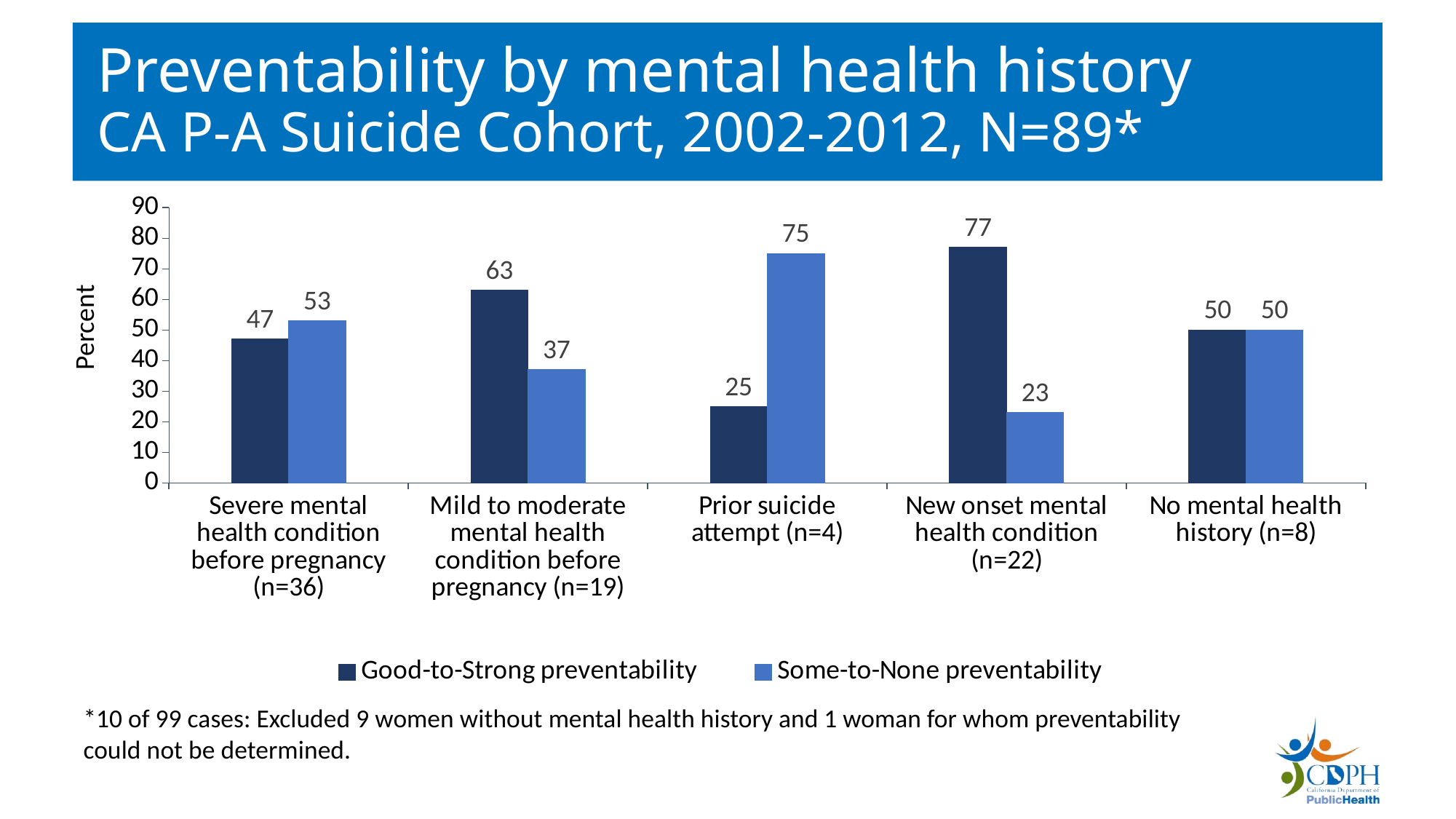
What is the Good-to-Strong preventability value for New onset mental health condition (n=22)? 77 What is the difference between the Good-to-Strong and Some-to-None preventability values for Mild to moderate mental health condition before pregnancy (n=19)? 26 What kind of chart is shown on the slide? Bar chart What are the Good-to-Strong and Some-to-None preventability values for No mental health history (n=8)? 50 and 50 What is the Some-to-None preventability value for Prior suicide attempt (n=4)? 75 How many series does the legend list? 2 Which category has the lowest Some-to-None preventability value? New onset mental health condition (n=22) Which category has the highest Good-to-Strong preventability value? New onset mental health condition (n=22) What is the Good-to-Strong preventability value for Severe mental health condition before pregnancy (n=36)? 47 How many mental health history categories are shown on the x axis? 5 What is the label of the y axis? Percent For Prior suicide attempt (n=4), which is larger: Good-to-Strong preventability or Some-to-None preventability? Some-to-None preventability